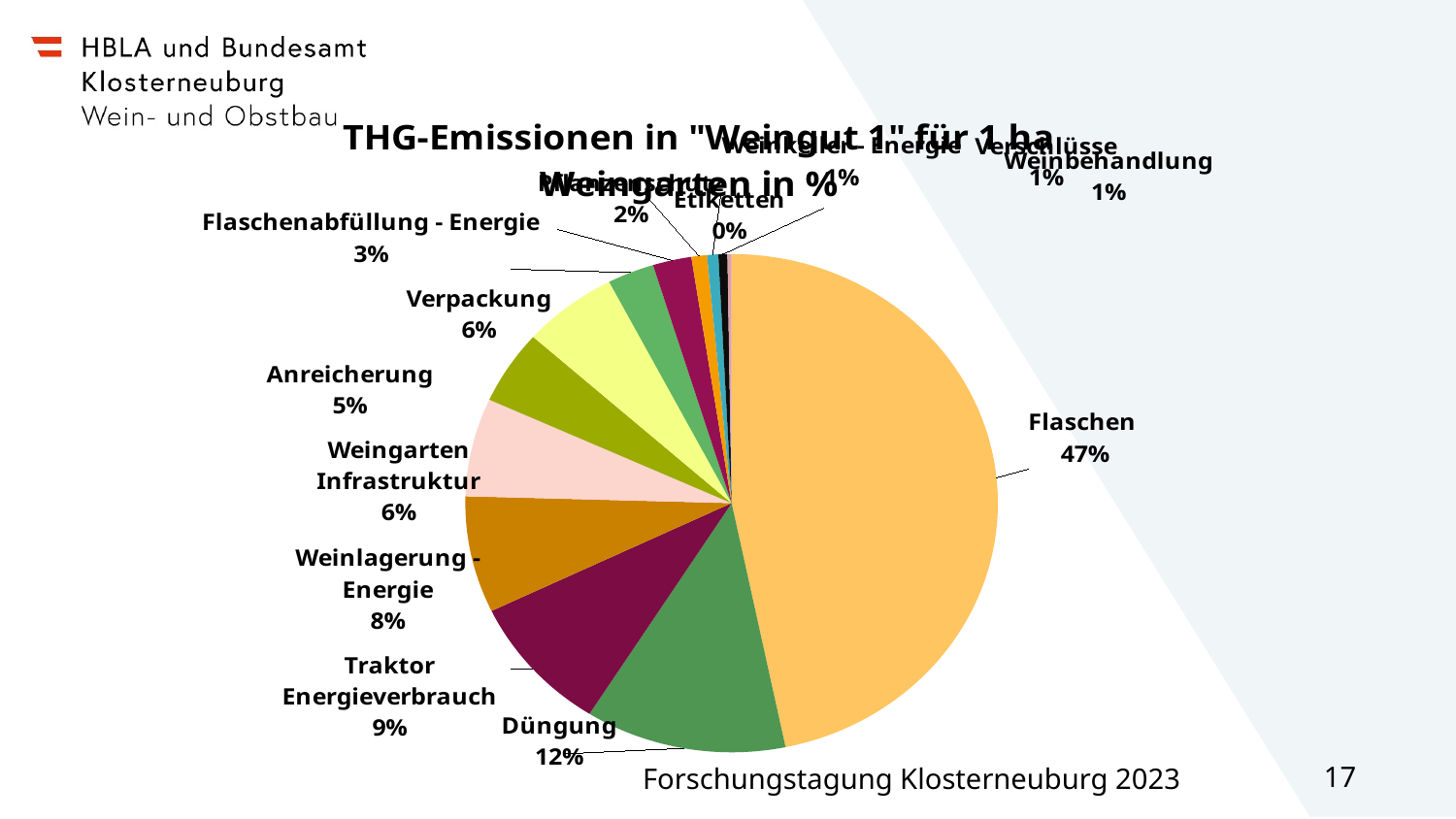
What type of chart is shown on the slide? Pie chart What is the difference in percentage points between Flaschen and Düngung? 35 What percentage is given for Flaschenabfüllung - Energie? 3% What share is shown for Anreicherung? 5% What value is shown for Etiketten? 0% What percentage is labelled for Weinlagerung - Energie? 8% What is the value for Traktor Energieverbrauch? 9% Which is larger, Traktor Energieverbrauch or Weinlagerung - Energie? Traktor Energieverbrauch What percentage is shown for Düngung? 12% What is the combined share of Verpackung and Weingarten Infrastruktur? 12% What share of the pie does Flaschen account for? 47% Which category has the largest slice of the pie? Flaschen